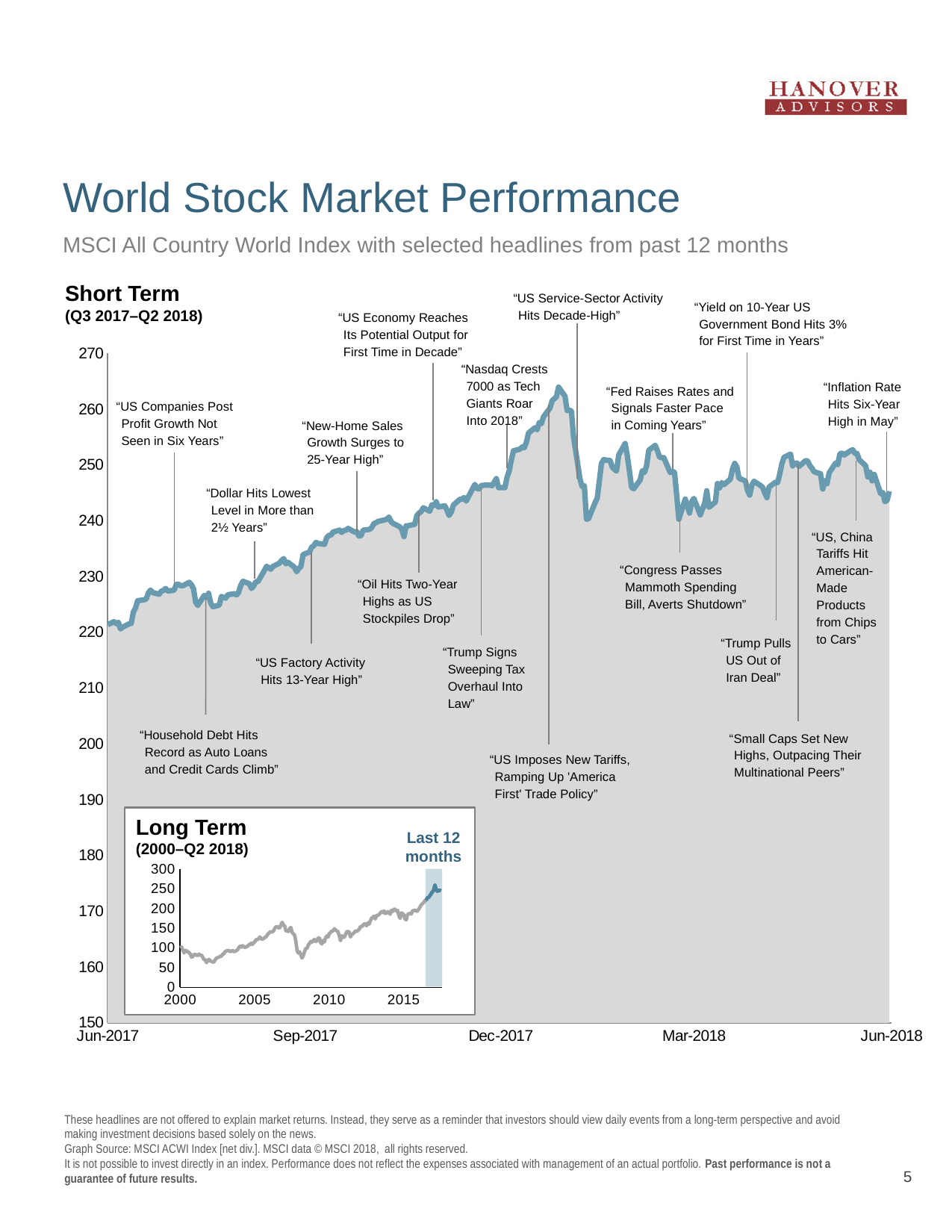
In the Long Term chart, is the index value at the end of the series (Q2 2018) greater or less than 200? greater What kind of chart is the Short Term (Q3 2017–Q2 2018) chart? Line chart In the Short Term chart, does the index overall rise or fall from Jun-2017 to Jun-2018? rise In the Long Term chart, does the index overall rise or fall from 2000 to Q2 2018? rise In the Short Term chart, is the index value at Jun-2017 greater or less than 230? less What period does the Long Term inset chart cover, according to its subtitle? 2000–Q2 2018 In the Short Term chart, is the highest point of the line greater or less than 250? greater What kind of chart is the Long Term (2000–Q2 2018) inset chart? Line chart What does the shaded region at the right of the Long Term chart represent, according to its label? Last 12 months How many date labels are shown on the x axis of the Short Term chart? 5